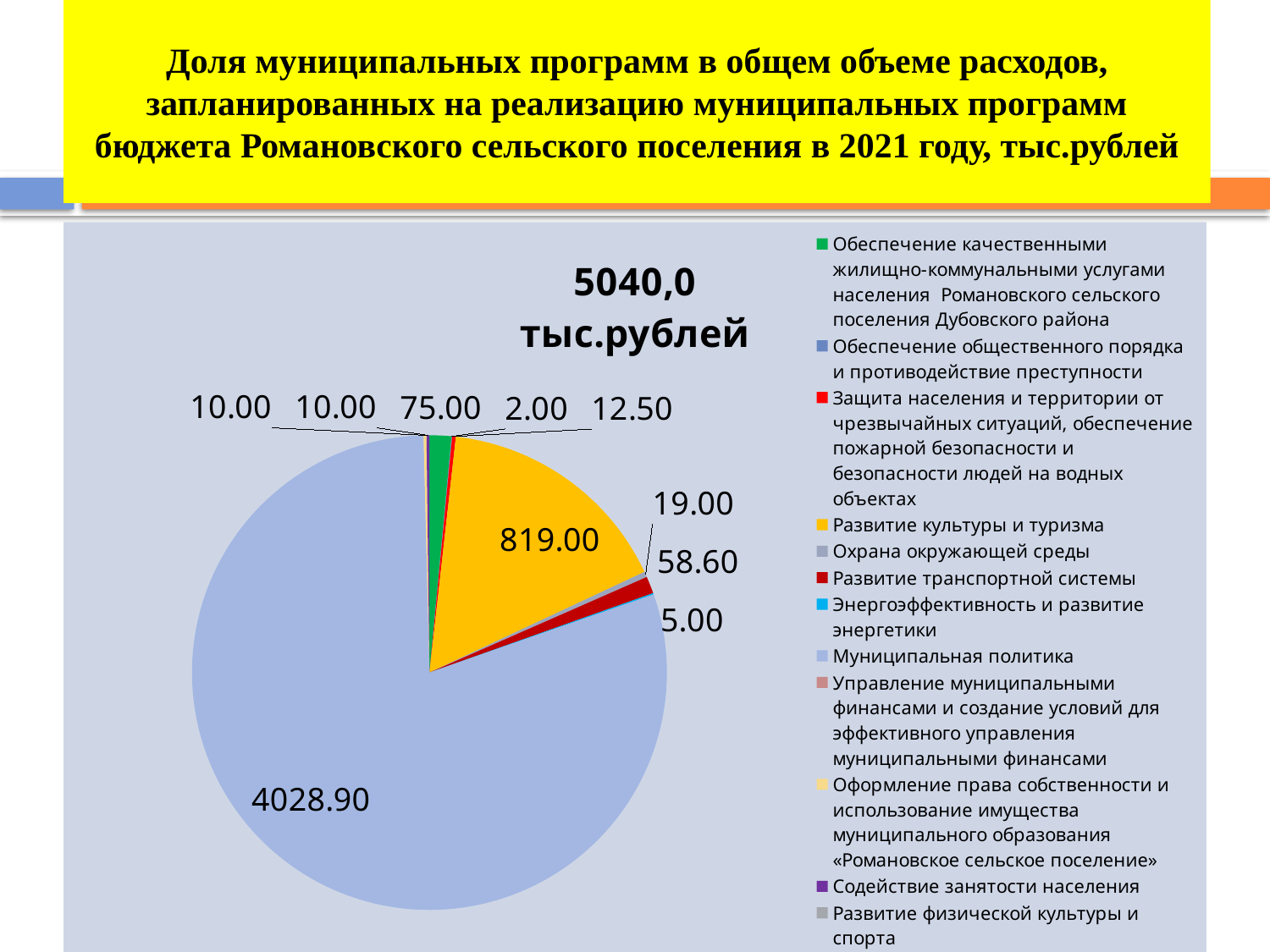
What colour is the largest slice of the pie chart? light blue What is the value of the largest slice of the pie chart? 4028.90 What is the difference between the largest slice (4028.90) and the yellow slice (819.00)? 3209.90 What is the value of the dark red slice 'Развитие транспортной системы'? 58.60 How many entries does the legend of the pie chart list? 12 What kind of chart is shown on the slide? pie chart What is the value of the yellow slice labelled 'Развитие культуры и туризма'? 819.00 What is the value of the green slice 'Обеспечение качественными жилищно-коммунальными услугами населения'? 75.00 What is the smallest value labelled on the pie chart? 2.00 Which is larger: the slice labelled 58.60 or the slice labelled 19.00? 58.60 What total amount is shown in the chart title? 5040,0 тыс.рублей What is the difference between the slice labelled 819.00 and the slice labelled 58.60? 760.40